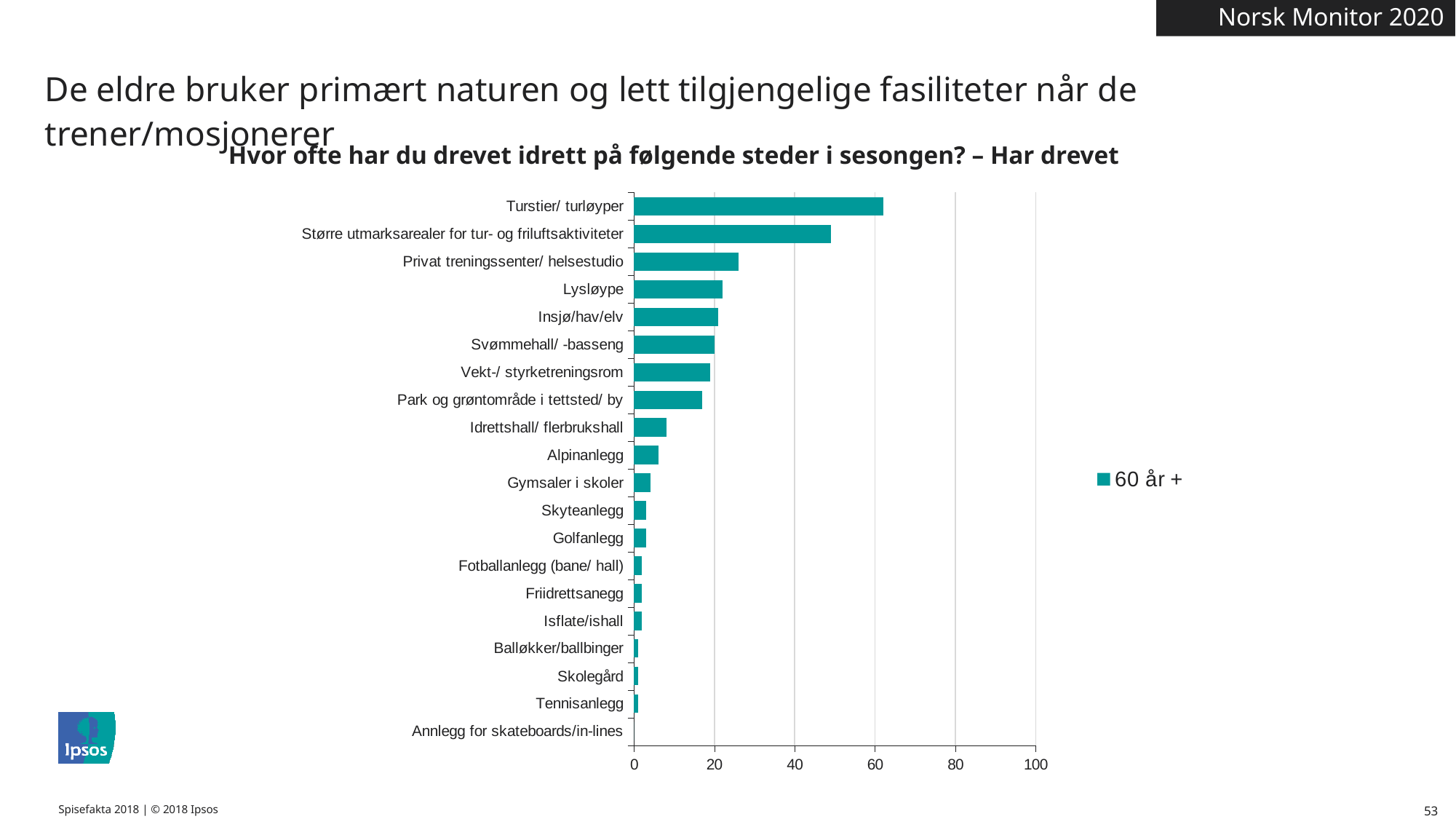
What is the legend entry for the series in the chart? 60 år + Is the value for Idrettshall/ flerbrukshall greater or less than 20? less Which category has the highest value? Turstier/ turløyper Is the value for Privat treningssenter/ helsestudio greater or less than 20? greater Which is larger, the value for Turstier/ turløyper or the value for Større utmarksarealer for tur- og friluftsaktiviteter? Turstier/ turløyper How many series does the legend list? 1 Is the value for Turstier/ turløyper greater or less than 60? greater Which is larger, the value for Alpinanlegg or the value for Privat treningssenter/ helsestudio? Privat treningssenter/ helsestudio Which category has the lowest value? Annlegg for skateboards/in-lines What kind of chart is shown on the slide? bar chart How many categories are plotted in the chart? 20